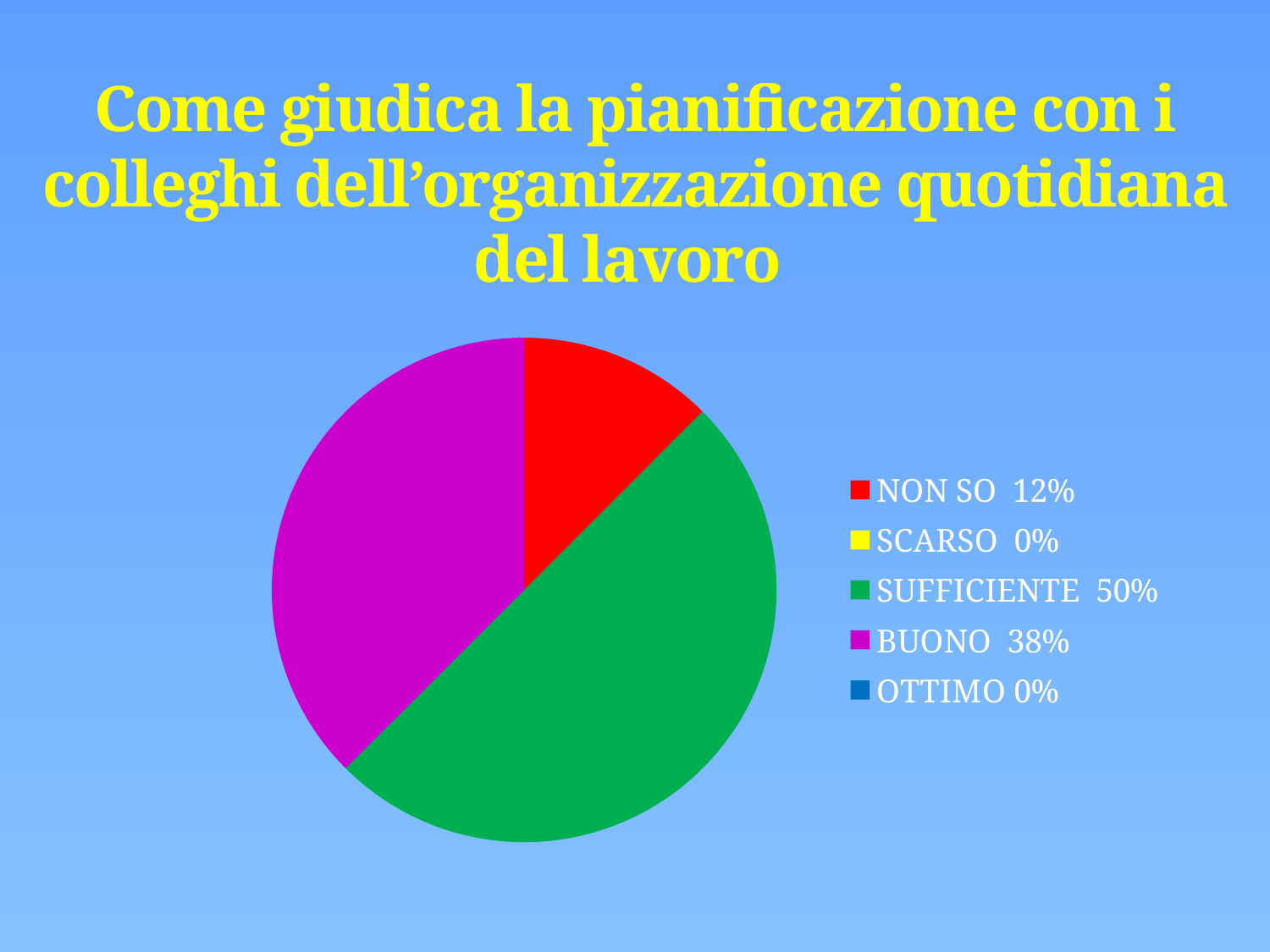
What share of the pie does BUONO represent? 38% What is the difference between the BUONO and NON SO shares? 26% How many categories does the legend list? 5 Which is larger, BUONO or NON SO? BUONO What is the value for OTTIMO? 0% What is the difference between the SUFFICIENTE and BUONO shares? 12% What share of the pie does SUFFICIENTE represent? 50% What is the value for SCARSO? 0% What kind of chart is shown on the slide? pie chart What colour is the SUFFICIENTE slice? green What is the value for NON SO? 12% Which category has the largest share of the pie? SUFFICIENTE